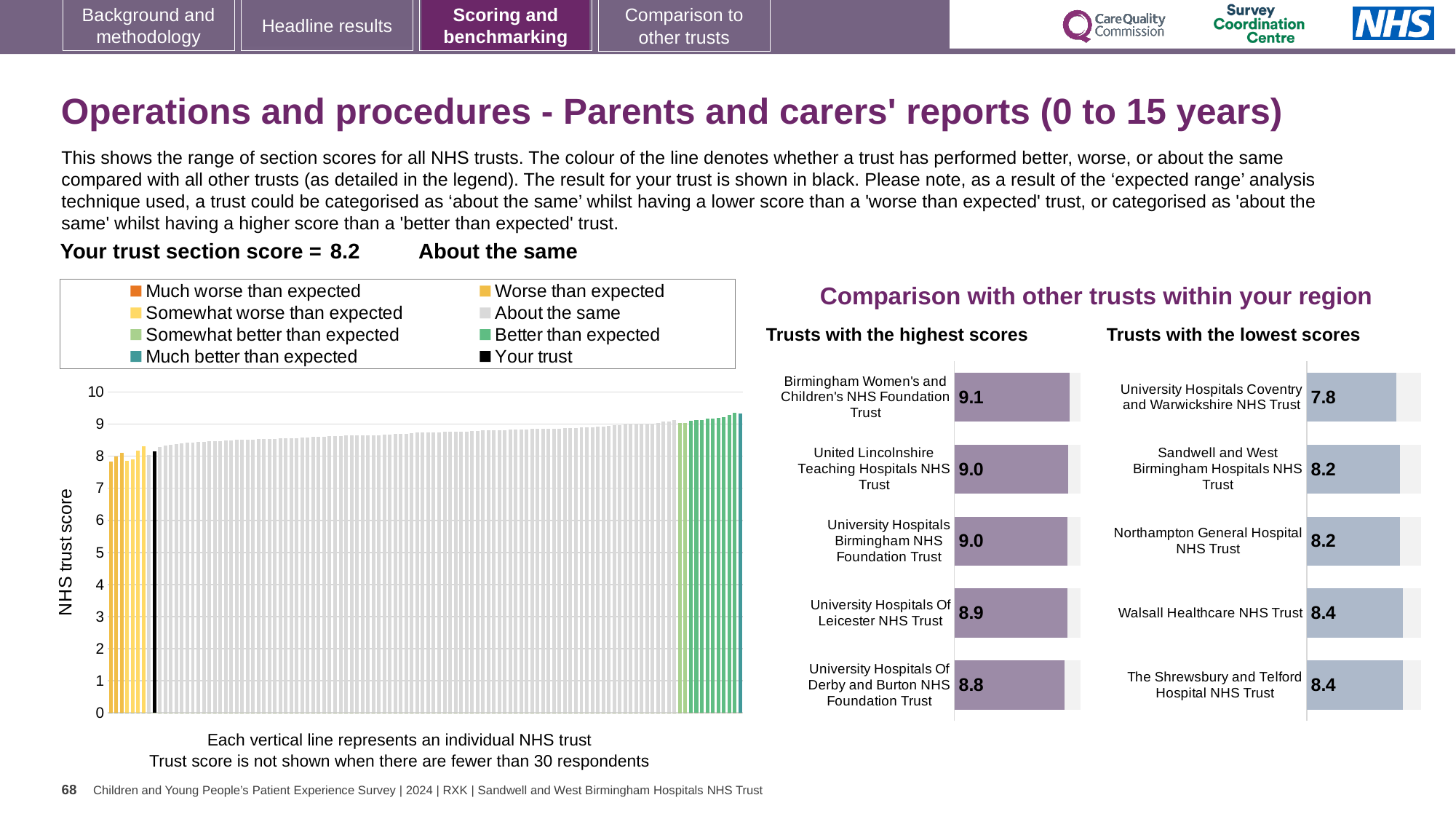
In the 'Trusts with the lowest scores' chart, what is the score for University Hospitals Coventry and Warwickshire NHS Trust? 7.8 In the 'Trusts with the lowest scores' chart, what is the difference between the scores of Sandwell and West Birmingham Hospitals NHS Trust and University Hospitals Coventry and Warwickshire NHS Trust? 0.4 In the 'Trusts with the highest scores' chart, what is the score for Birmingham Women's and Children's NHS Foundation Trust? 9.1 What kind of chart is the main 'NHS trust score' chart on the left of the slide? Bar chart In the main 'NHS trust score' chart, do the bar values rise or fall from left to right? Rise How many trusts are shown in the 'Trusts with the highest scores' chart? 5 In the 'Trusts with the highest scores' chart, what is the difference between the scores of Birmingham Women's and Children's NHS Foundation Trust and University Hospitals Of Derby and Burton NHS Foundation Trust? 0.3 In the 'Trusts with the highest scores' chart, which trust has the highest score? Birmingham Women's and Children's NHS Foundation Trust How many entries does the legend of the main 'NHS trust score' chart list? 8 In the 'Trusts with the lowest scores' chart, what is the score for Walsall Healthcare NHS Trust? 8.4 In the 'Trusts with the lowest scores' chart, which has the higher score: Walsall Healthcare NHS Trust or Sandwell and West Birmingham Hospitals NHS Trust? Walsall Healthcare NHS Trust In the 'Trusts with the lowest scores' chart, which trust has the lowest score? University Hospitals Coventry and Warwickshire NHS Trust